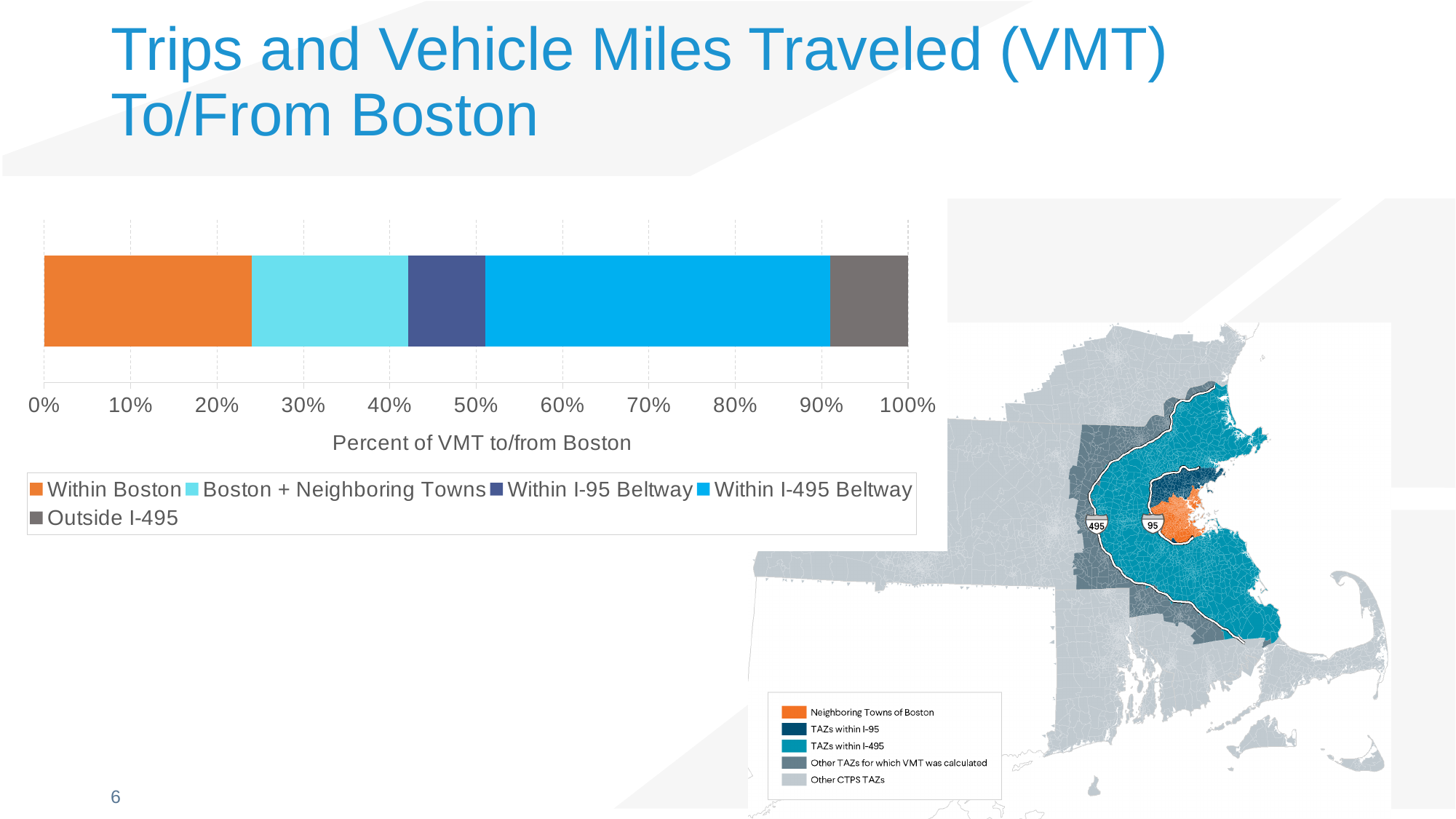
Which is larger in the bar chart: the share for Within I-495 Beltway or the share for Within Boston? Within I-495 Beltway Is the share for Outside I-495 greater or less than 20%? less Is the share for Within I-95 Beltway greater or less than 20%? less What is the title of the horizontal axis of the bar chart? Percent of VMT to/from Boston How many series does the legend of the bar chart list? 5 What kind of chart is shown on the left of the slide? Stacked bar chart Is the share for Within I-495 Beltway greater or less than 30%? greater Which series accounts for the largest share of VMT to/from Boston in the bar chart? Within I-495 Beltway Which is larger in the bar chart: the share for Within Boston or the share for Boston + Neighboring Towns? Within Boston What colour represents Within Boston in the bar chart? Orange